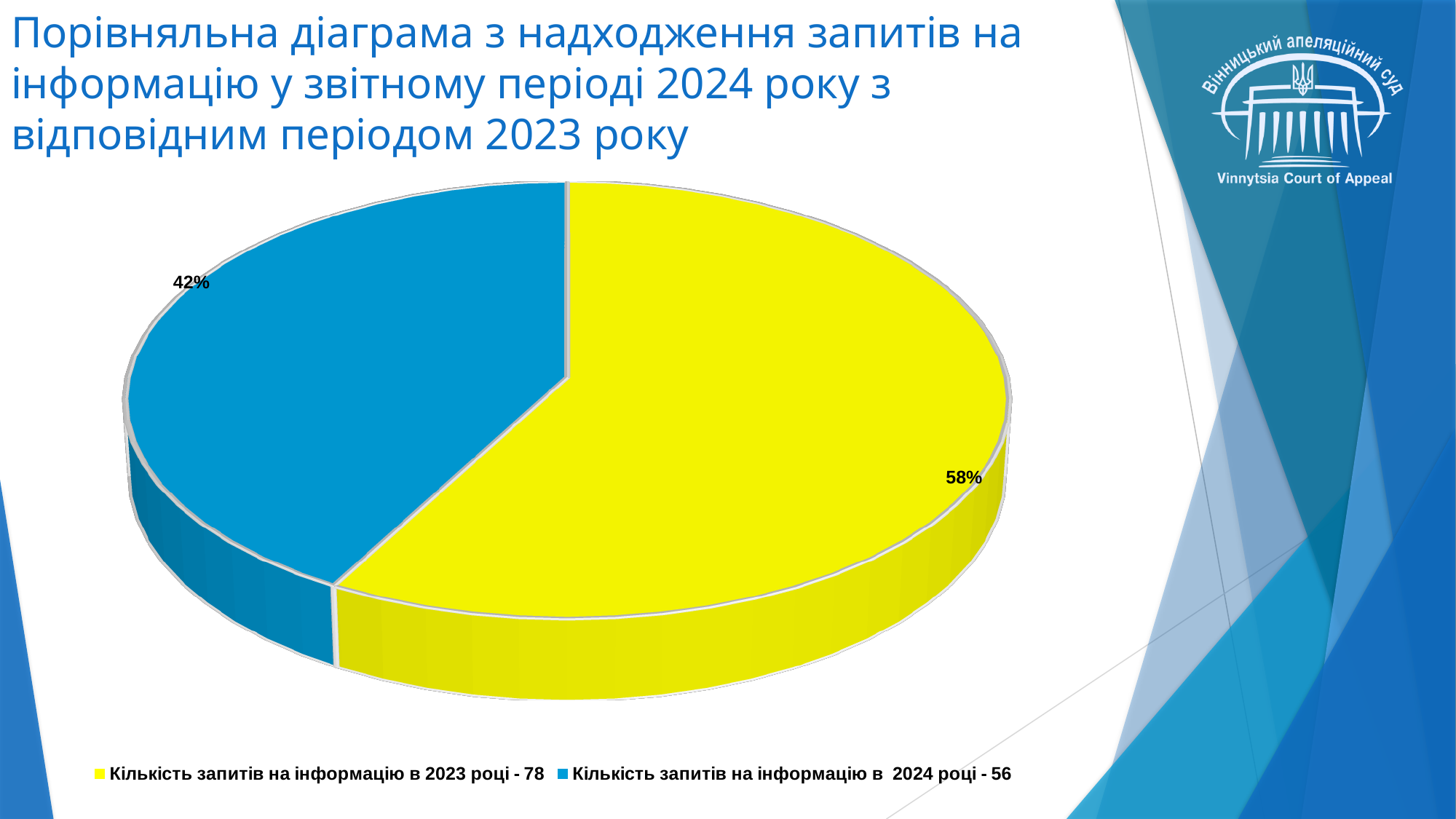
What colour is the slice representing requests in 2024? blue What is the difference between the number of requests in 2023 and in 2024? 22 How many slices does the pie chart have? 2 According to the legend, how many information requests were received in 2024? 56 How many entries does the legend list? 2 Which year has the larger slice of the pie, 2023 or 2024? 2023 What is the difference in percentage points between the 2023 slice and the 2024 slice? 16 What percentage share does the blue slice (requests in 2024) have? 42% What percentage share does the yellow slice (requests in 2023) have? 58% According to the legend, how many information requests were received in 2023? 78 What kind of chart is shown on the slide? pie chart Which slice is the smallest in the pie chart? Кількість запитів на інформацію в 2024 році - 56